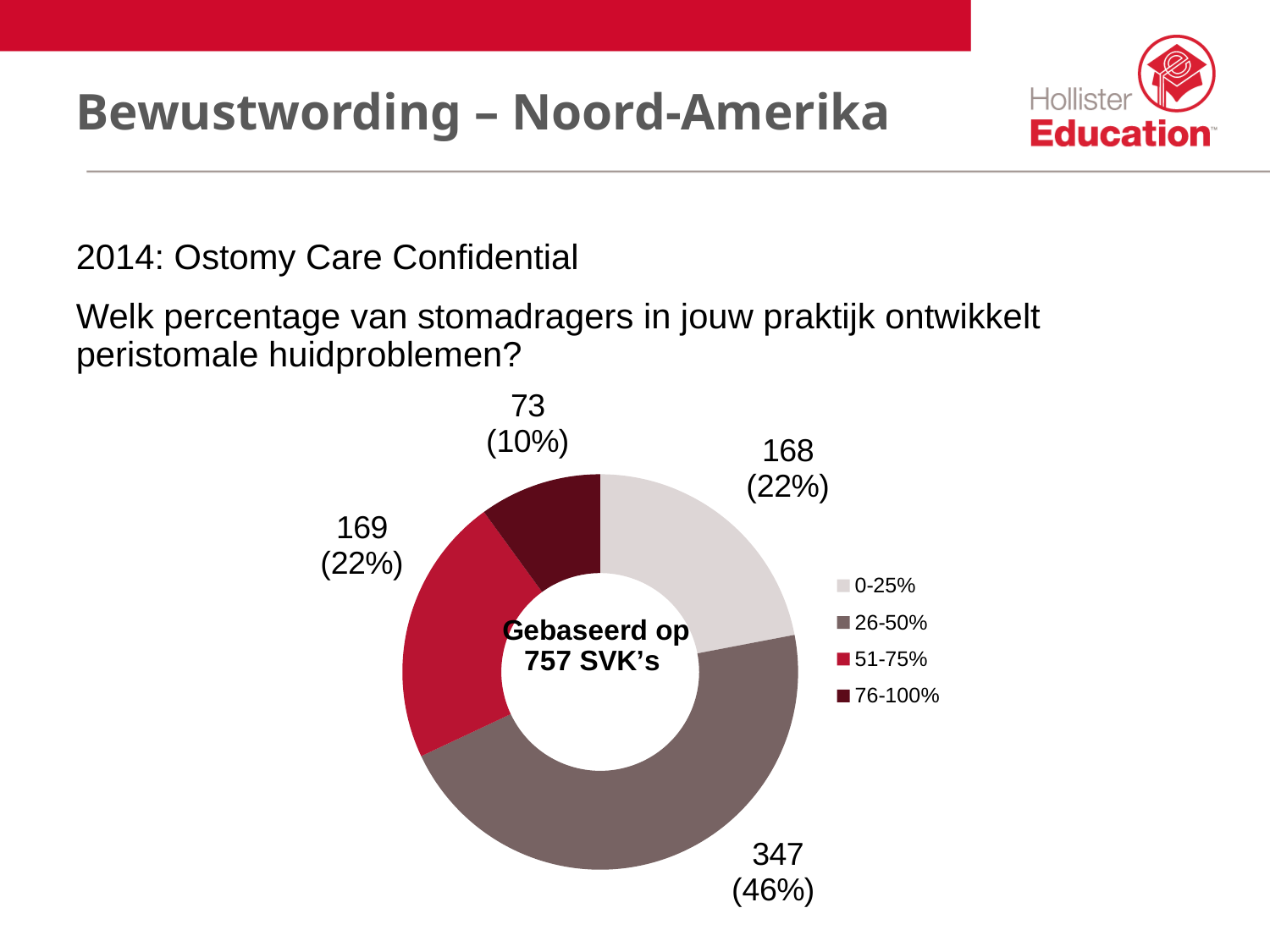
How many respondents chose the 26-50% category? 347 How many respondents chose the 0-25% category? 168 How many respondents chose the 76-100% category? 73 What is the difference between the number of respondents in the 26-50% category and the 76-100% category? 274 What percentage share does the 26-50% category have? 46% What percentage share does the 51-75% category have? 22% How many categories does the chart show? 4 According to the text in the centre of the chart, how many SVK's is the chart based on? 757 Which has more respondents, the 26-50% category or the 51-75% category? 26-50% Which category has the largest share of the chart? 26-50% Which category has the smallest share of the chart? 76-100% What kind of chart is shown on the slide? doughnut chart